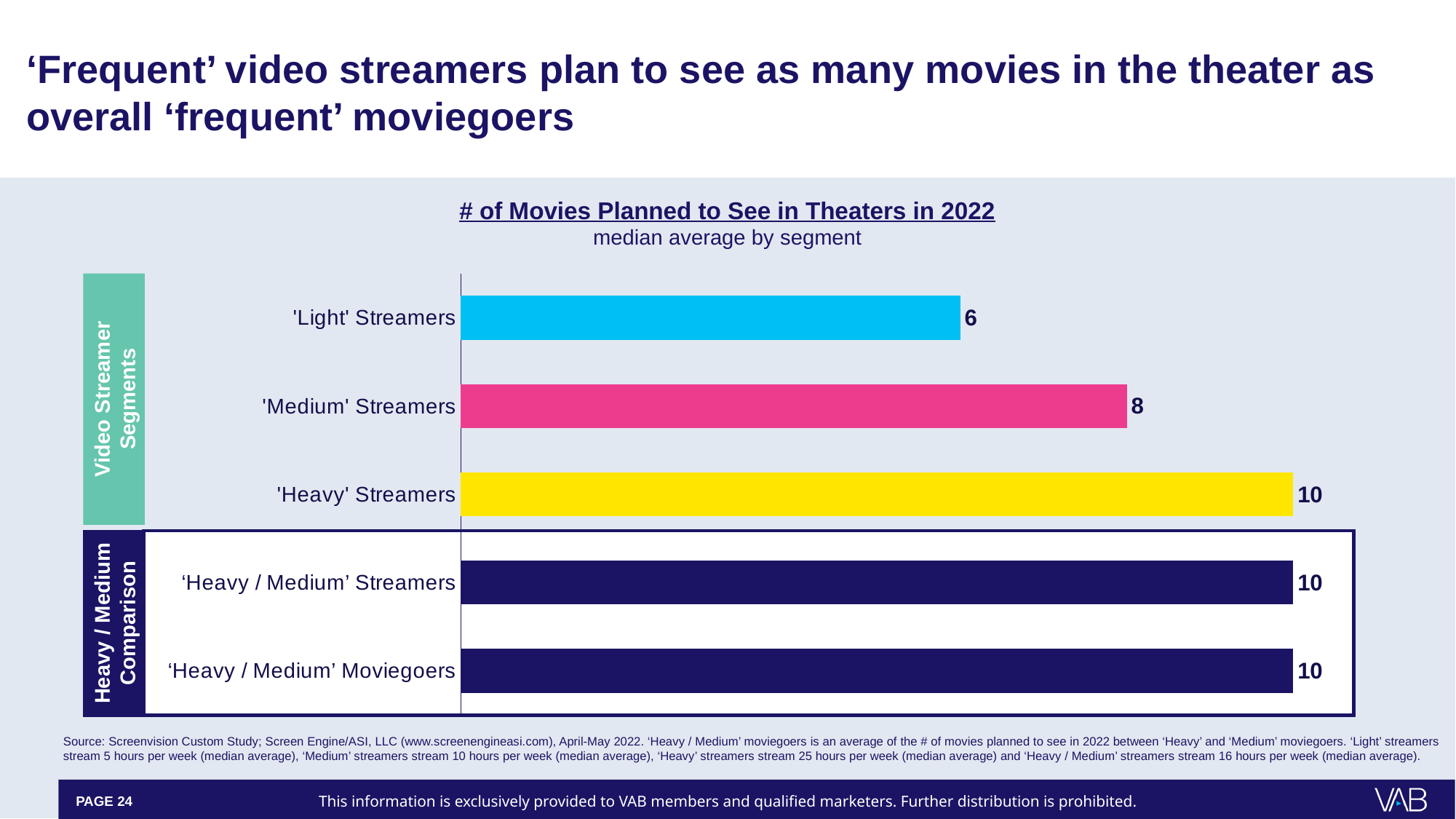
What is the value shown for 'Medium' Streamers? 8 How many segments (bars) are shown in the chart? 5 What is the difference between the values for 'Heavy' Streamers and 'Light' Streamers? 4 Which segment has the lowest number of movies planned to see in theaters? 'Light' Streamers What is the value shown for 'Heavy / Medium' Moviegoers? 10 Do the values rise or fall going from 'Light' Streamers to 'Heavy' Streamers? Rise Which is larger, the value for 'Medium' Streamers or 'Light' Streamers? 'Medium' Streamers What type of chart is shown on the slide? Bar chart What is the value shown for 'Heavy' Streamers? 10 What is the median number of movies 'Light' Streamers plan to see in theaters in 2022? 6 What is the difference between the values for 'Medium' Streamers and 'Light' Streamers? 2 What is the title of the chart? # of Movies Planned to See in Theaters in 2022